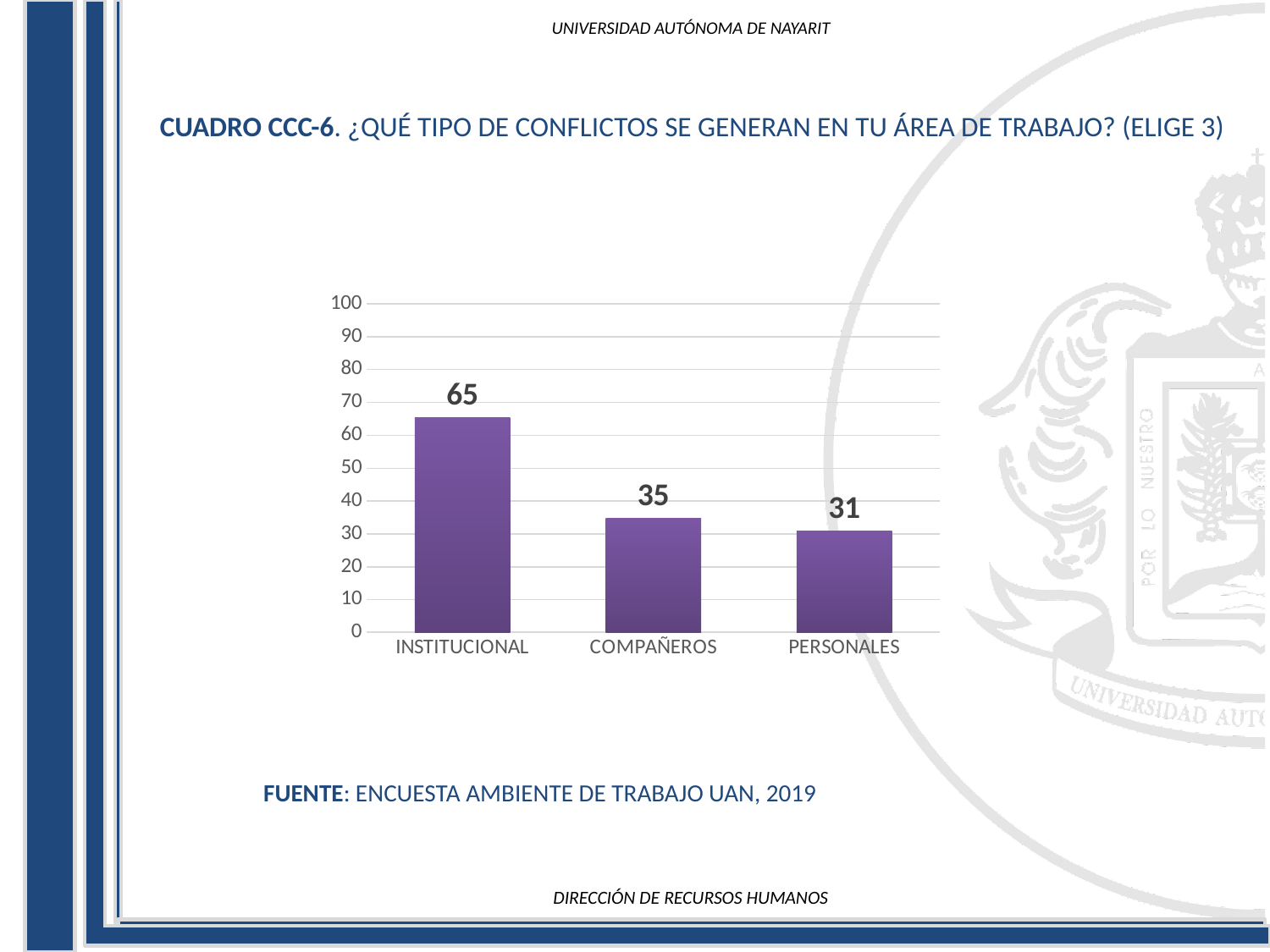
Is the value for INSTITUCIONAL greater or less than 50? greater How many categories are shown on the x axis? 3 Which category has the highest value? INSTITUCIONAL What is the difference between the values for INSTITUCIONAL and COMPAÑEROS? 30 What is the source cited below the chart? ENCUESTA AMBIENTE DE TRABAJO UAN, 2019 What kind of chart is shown on the slide? bar chart Which is larger, the value for INSTITUCIONAL or the value for PERSONALES? INSTITUCIONAL What is the value for COMPAÑEROS? 35 What is the difference between the values for COMPAÑEROS and PERSONALES? 4 What is the value for INSTITUCIONAL? 65 What is the value for PERSONALES? 31 Which category has the lowest value? PERSONALES